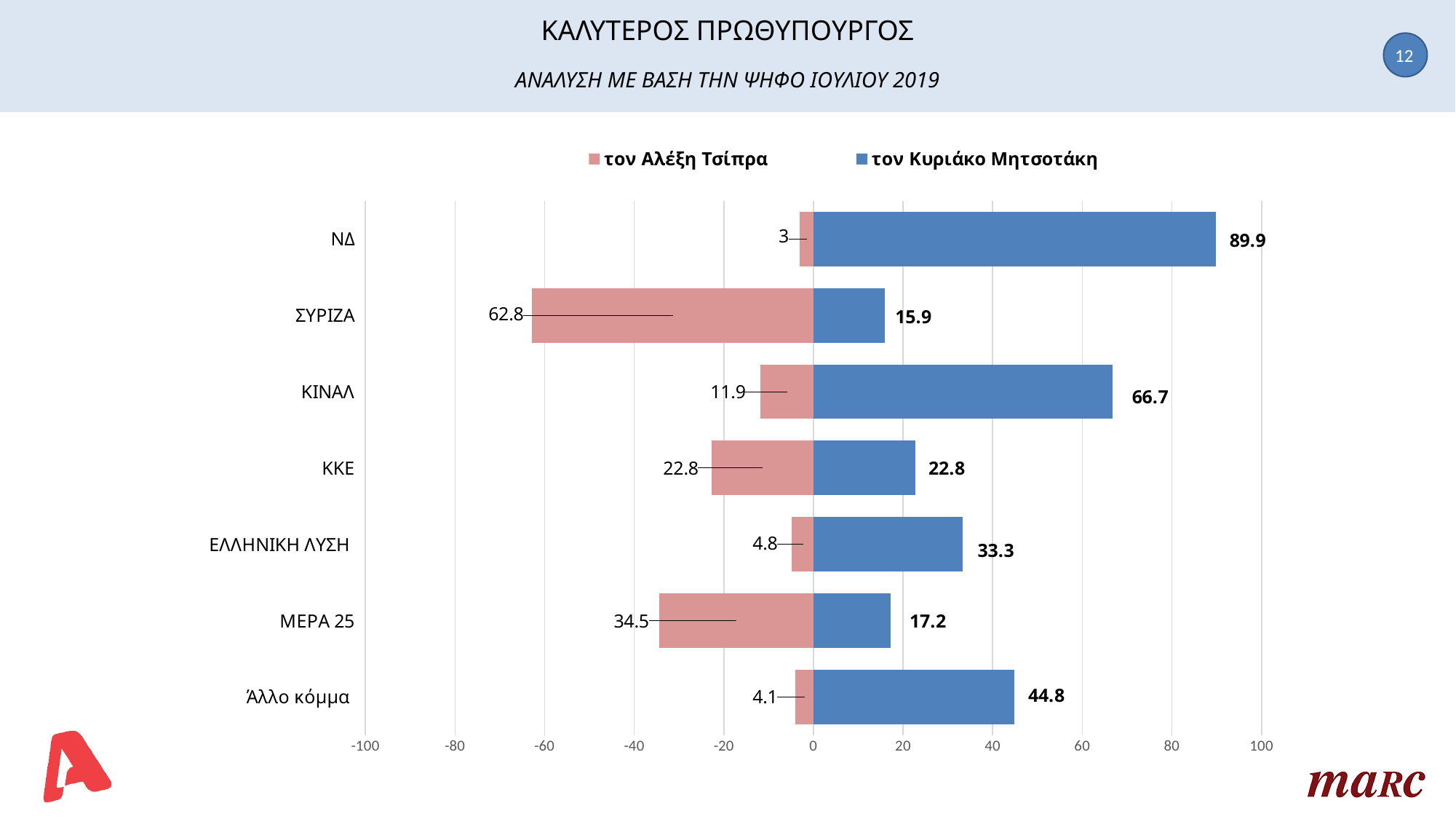
Which category has the highest value for τον Κυριάκο Μητσοτάκη? ΝΔ What is the value for τον Αλέξη Τσίπρα among ΣΥΡΙΖΑ voters? 62.8 What is the value for τον Αλέξη Τσίπρα among ΜΕΡΑ 25 voters? 34.5 Which colour represents τον Κυριάκο Μητσοτάκη in the chart? Blue How many series does the legend list? 2 What is the value for τον Κυριάκο Μητσοτάκη among ΝΔ voters? 89.9 What is the value for τον Κυριάκο Μητσοτάκη among ΚΙΝΑΛ voters? 66.7 How many party categories are shown on the chart? 7 Which is larger for ΣΥΡΙΖΑ voters: the value for τον Αλέξη Τσίπρα or for τον Κυριάκο Μητσοτάκη? τον Αλέξη Τσίπρα What is the difference between the τον Κυριάκο Μητσοτάκη value for ΝΔ and for ΚΙΝΑΛ? 23.2 Which category has the lowest value for τον Αλέξη Τσίπρα? ΝΔ What kind of chart is shown on the slide? Bar chart